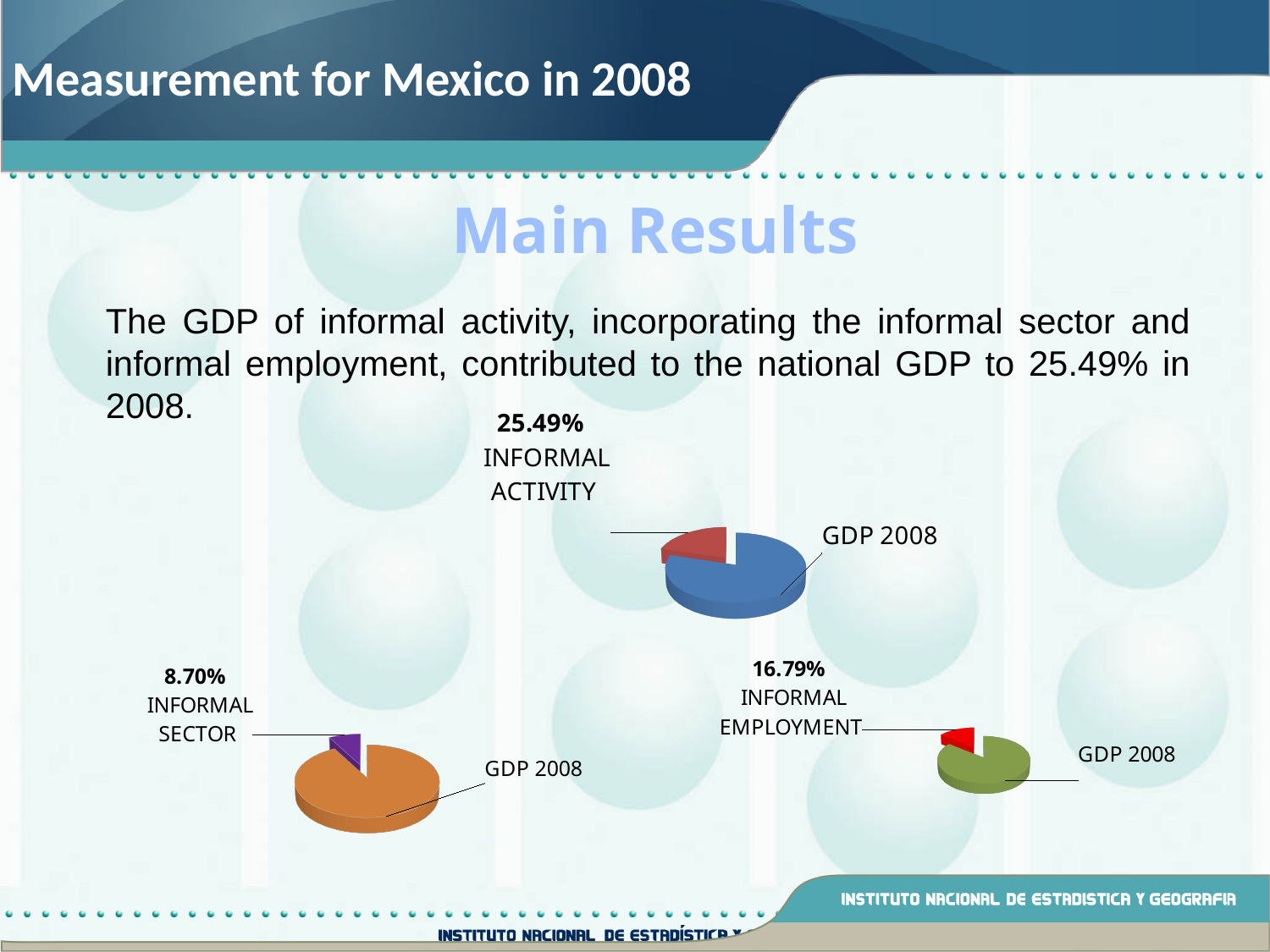
In the bottom-left pie chart, what share does the INFORMAL SECTOR slice represent? 8.70% In the bottom-right pie chart, which slice is the largest? GDP 2008 In the bottom-right pie chart, what share does the INFORMAL EMPLOYMENT slice represent? 16.79% How many slices does the bottom-left pie chart have? 2 In the top pie chart, which slice is larger, INFORMAL ACTIVITY or GDP 2008? GDP 2008 What colour is the large GDP 2008 slice in the bottom-left pie chart? orange What kind of chart is the top chart on the slide? pie chart In the top pie chart, what share does the INFORMAL ACTIVITY slice represent? 25.49% In the bottom-left pie chart, which slice is smaller, INFORMAL SECTOR or GDP 2008? INFORMAL SECTOR What is the difference between the INFORMAL EMPLOYMENT share in the bottom-right pie chart and the INFORMAL SECTOR share in the bottom-left pie chart? 8.09% What is the difference between the INFORMAL ACTIVITY share in the top pie chart and the INFORMAL SECTOR share in the bottom-left pie chart? 16.79% How many pie charts are shown on the slide? 3